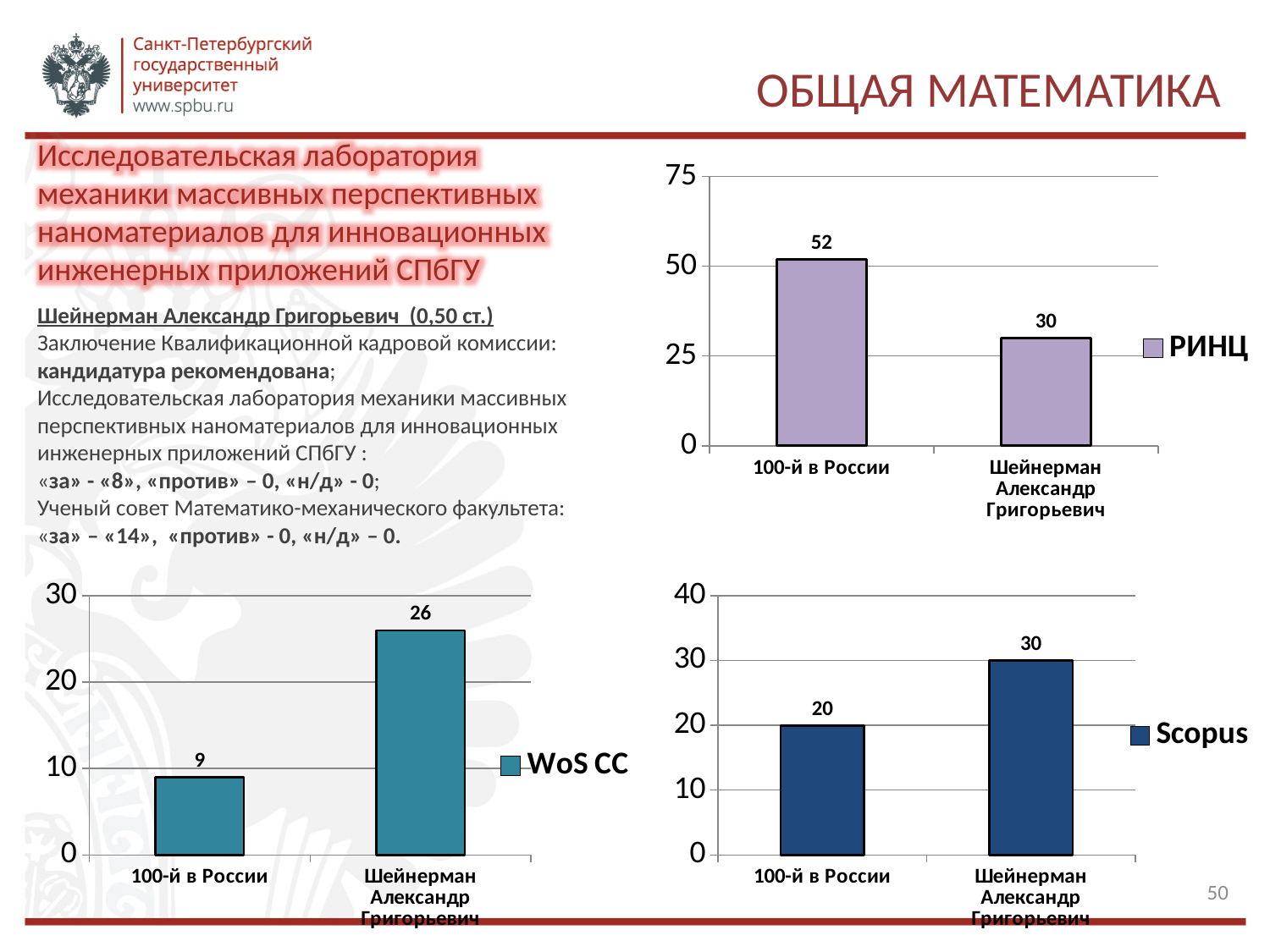
In the WoS CC chart, which category has the higher value? Шейнерман Александр Григорьевич In the WoS CC chart, what is the value for 100-й в России? 9 How many charts are shown on the slide? 3 In the РИНЦ chart, what is the value for 100-й в России? 52 In the РИНЦ chart, what is the value for Шейнерман Александр Григорьевич? 30 In the РИНЦ chart, what is the difference between the values for 100-й в России and Шейнерман Александр Григорьевич? 22 What type of chart is the Scopus chart? bar chart In the РИНЦ chart, which category has the lower value? Шейнерман Александр Григорьевич In the Scopus chart, what is the value for 100-й в России? 20 In the WoS CC chart, what is the value for Шейнерман Александр Григорьевич? 26 In the Scopus chart, what is the difference between the values for Шейнерман Александр Григорьевич and 100-й в России? 10 In the Scopus chart, what is the value for Шейнерман Александр Григорьевич? 30